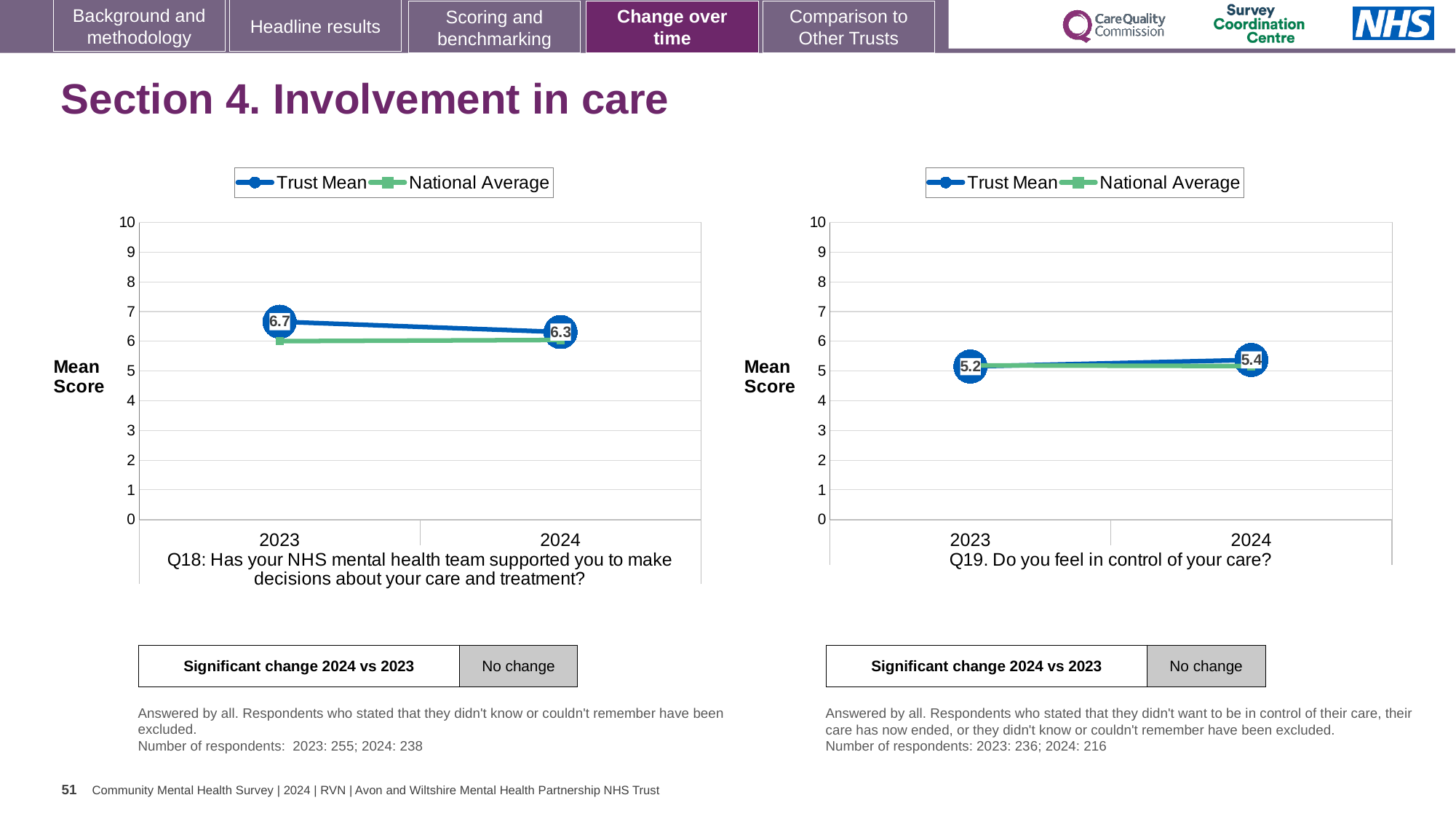
In the Q18 chart, is the Trust Mean for 2023 greater or less than 6? greater In the Q18 chart, which year has the higher Trust Mean, 2023 or 2024? 2023 In the Q19 chart, what is the difference between the Trust Mean in 2024 and in 2023? 0.2 What kind of chart is the Q18 chart? line chart In the Q18 chart, by how much did the Trust Mean change from 2023 to 2024? 0.4 In the Q19 chart, what is the Trust Mean for 2024? 5.4 In the Q18 chart, does the Trust Mean rise or fall from 2023 to 2024? fall In the Q19 chart, what is the Trust Mean for 2023? 5.2 In the Q18 chart, what is the Trust Mean for 2024? 6.3 How many series does the legend of the Q19 chart list? 2 In the Q18 chart, what is the Trust Mean for 2023? 6.7 In the Q19 chart, does the Trust Mean rise or fall from 2023 to 2024? rise